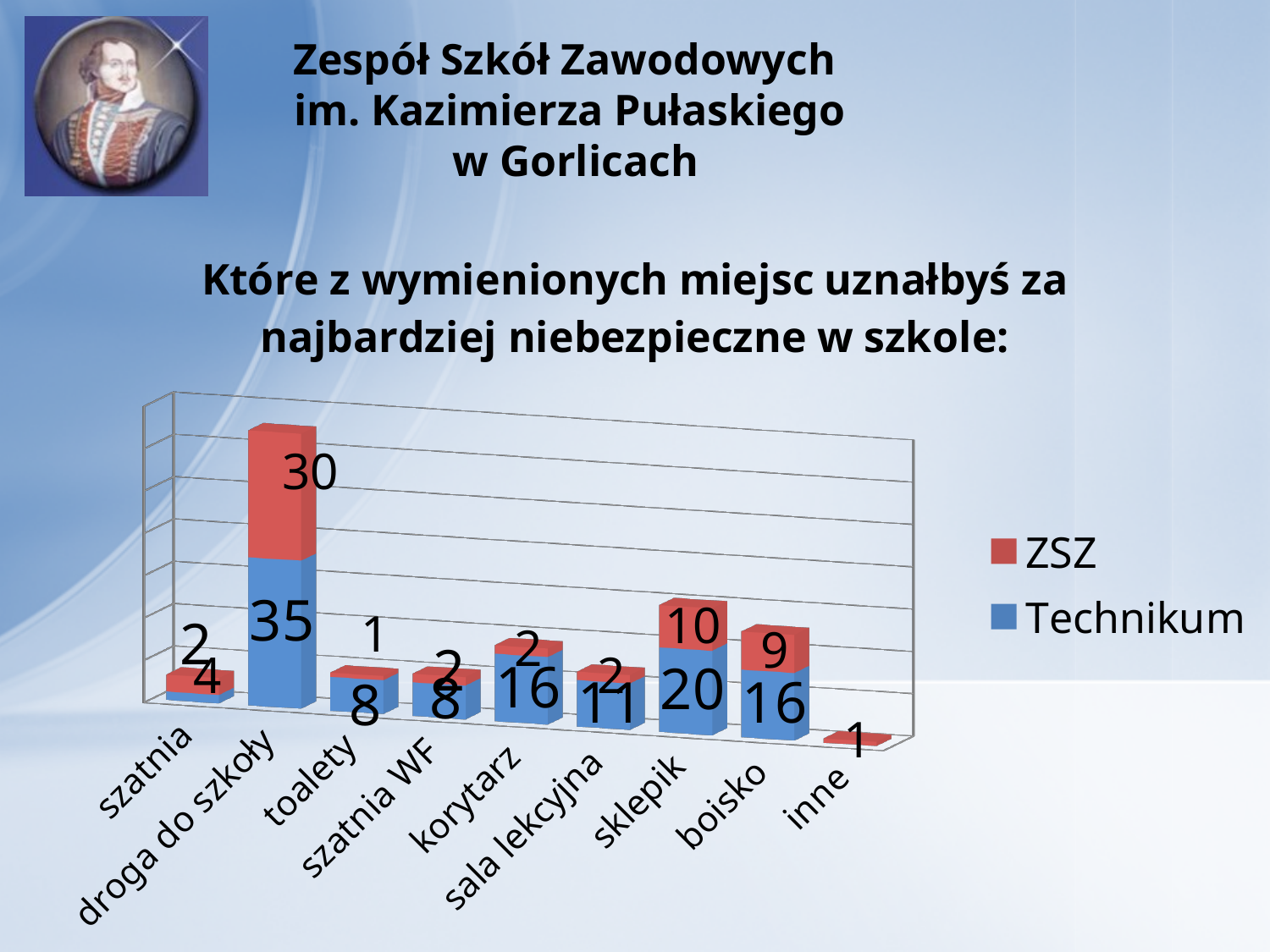
Which category has the highest ZSZ value? droga do szkoły What is the Technikum value for "sala lekcyjna"? 11 What is the Technikum value for "droga do szkoły"? 35 What is the total of the stacked bar for "droga do szkoły"? 65 Which has a larger Technikum value, "sklepik" or "boisko"? sklepik Which category has the highest Technikum value? droga do szkoły How many series does the legend list? 2 What is the ZSZ value for "sklepik"? 10 What kind of chart is shown on the slide? stacked bar chart How many categories are shown on the x axis? 9 What is the difference between the Technikum and ZSZ values for "sklepik"? 10 What is the ZSZ value for "boisko"? 9